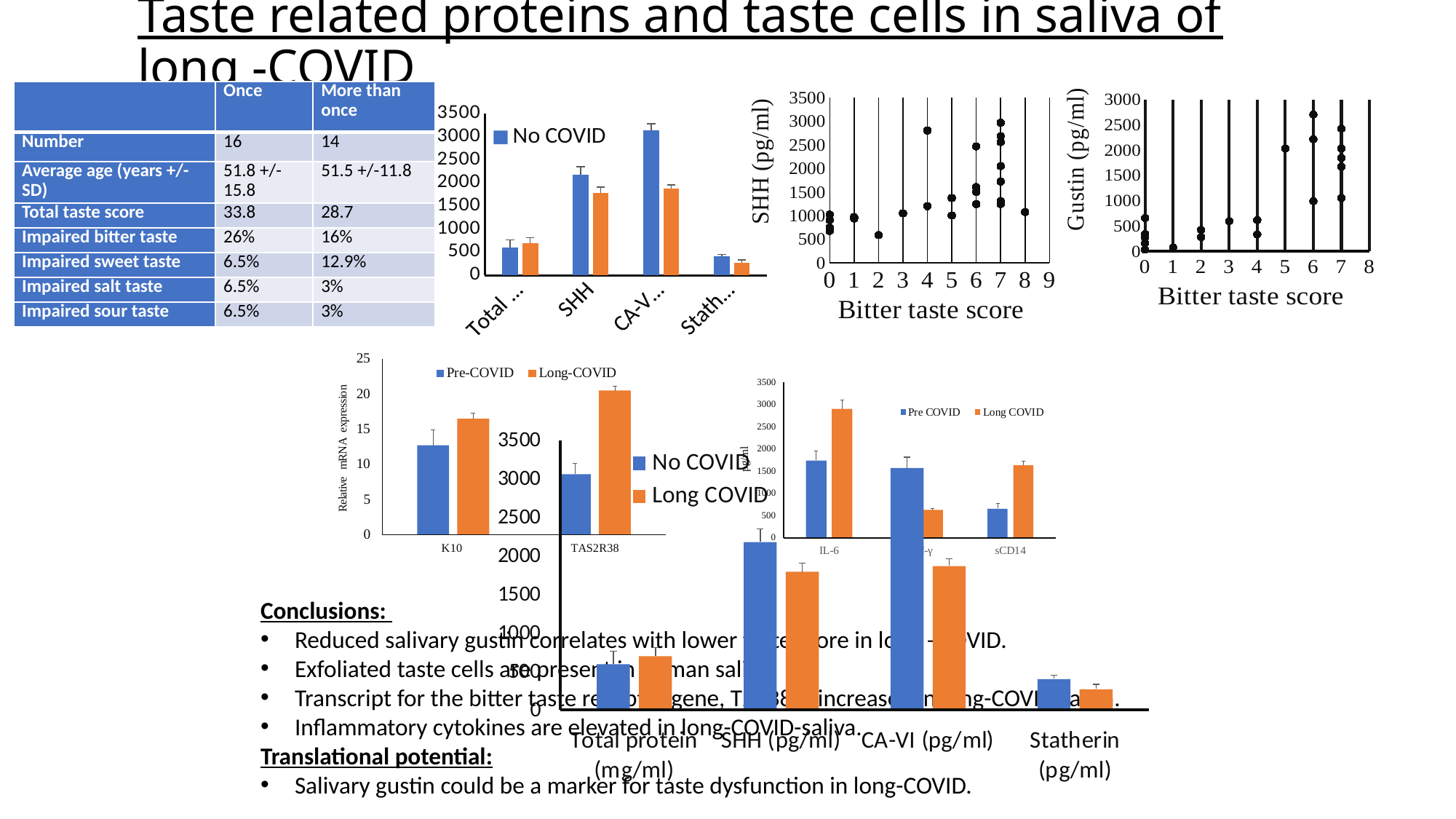
In the large bottom chart with categories Total protein, SHH, CA-VI and Statherin, is the Long COVID value for Statherin (pg/ml) greater or less than 500? less What is the x-axis title of the scatter chart whose y axis is labelled Gustin (pg/ml)? Bitter taste score In the large bottom chart with categories Total protein, SHH, CA-VI and Statherin, which series has the larger value for CA-VI (pg/ml), No COVID or Long COVID? No COVID In the large bottom chart with categories Total protein, SHH, CA-VI and Statherin, how many categories are shown on the x axis? 4 In the Relative mRNA expression chart with categories K10 and TAS2R38, is the Long-COVID value for TAS2R38 greater or less than 15? greater In the Relative mRNA expression chart with categories K10 and TAS2R38, which series has the larger value for TAS2R38, Pre-COVID or Long-COVID? Long-COVID In the top-middle bar chart with categories Total, SHH, CA-V and Stath, is the blue (No COVID) value for CA-V greater or less than 2500? greater In the top-middle bar chart with categories Total, SHH, CA-V and Stath, which series has the larger value for SHH, the blue series or the orange series? the blue series In the large bottom chart with categories Total protein, SHH, CA-VI and Statherin, how many series does the legend list? 2 What kind of chart is the large chart at the bottom of the slide with categories Total protein (mg/ml), SHH (pg/ml), CA-VI (pg/ml) and Statherin (pg/ml)? bar chart In the scatter chart with y axis Gustin (pg/ml), do the gustin values generally rise or fall as the bitter taste score increases? rise